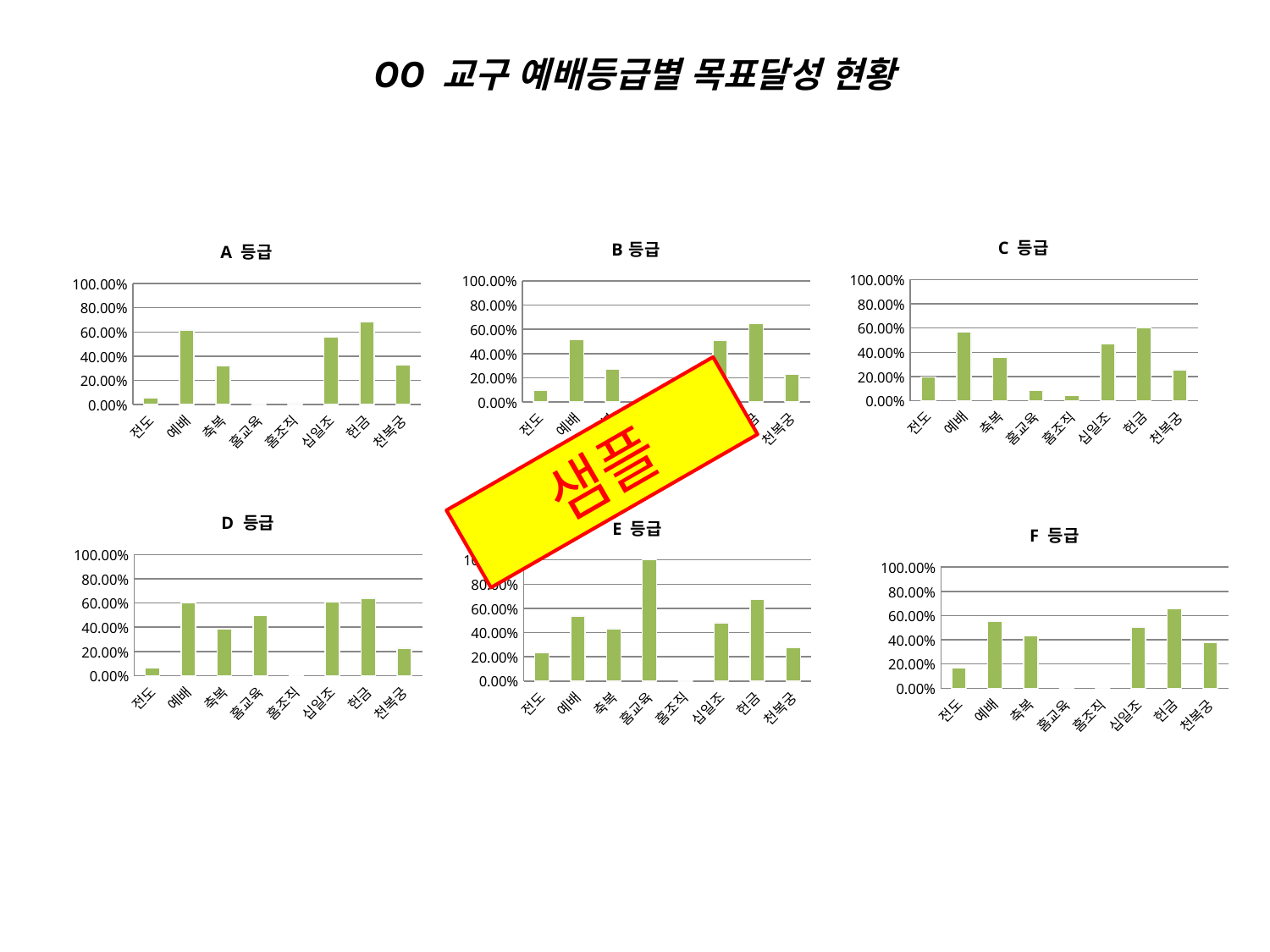
In the D 등급 chart, is the value for 홈교육 greater or less than 40%? greater In the C 등급 chart, is the value for 십일조 greater or less than 40%? greater What is the title of the slide? OO 교구 예배등급별 목표달성 현황 In the F 등급 chart, which is larger, the value for 헌금 or the value for 예배? 헌금 How many charts are shown on the slide? 6 In the E 등급 chart, is the value for 홈교육 greater or less than 80%? greater In the A 등급 chart, which category has the highest value? 헌금 What kind of chart is the A 등급 chart? bar chart How many categories are shown on the x axis of the F 등급 chart? 8 In the E 등급 chart, which category has the highest value? 홈교육